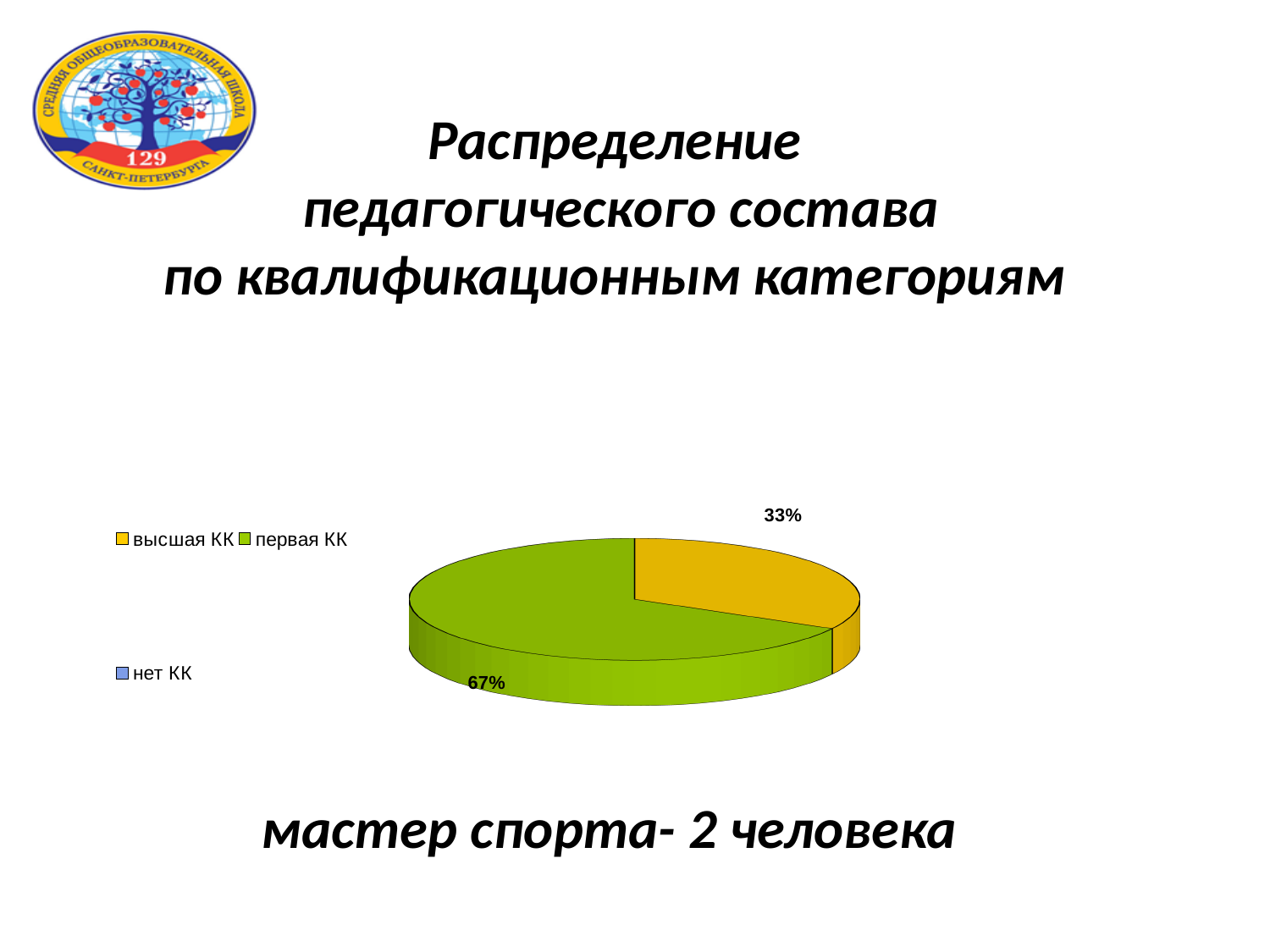
What share of the pie does the "первая КК" slice represent? 67% Which category has the largest slice of the pie? первая КК Which is larger, the share for "первая КК" or the share for "высшая КК"? первая КК What kind of chart is shown on the slide? pie chart How many entries does the legend list? 3 Which of the two labelled slices is smaller, "высшая КК" or "первая КК"? высшая КК What is the difference in percentage points between the "первая КК" and "высшая КК" slices? 34% How many slices with a printed percentage label are visible in the pie? 2 What colour is the "высшая КК" slice? yellow What colour is the "первая КК" slice? green What share of the pie does the "высшая КК" slice represent? 33%